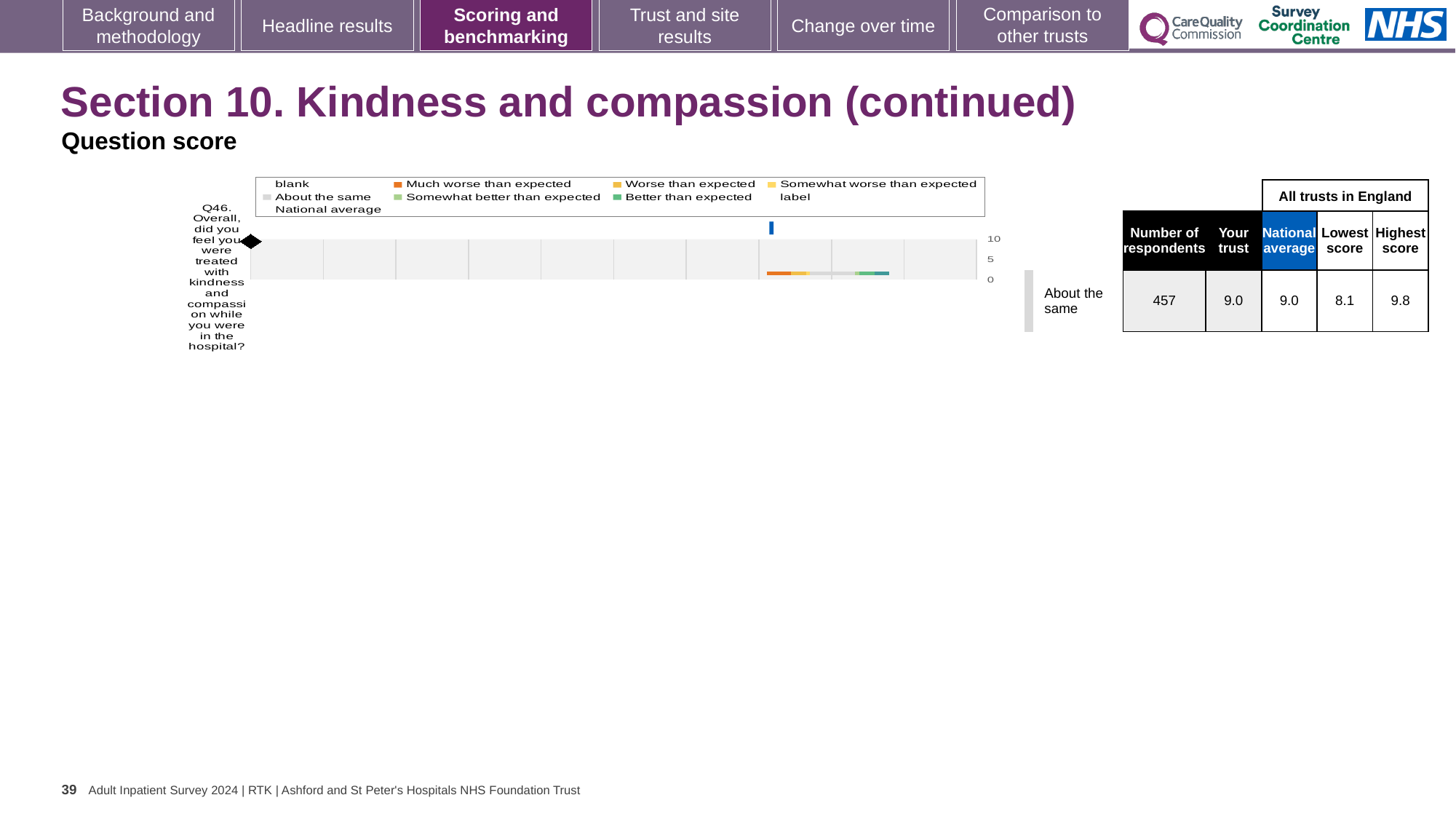
According to the table beside the chart, what is the national average score for Q46? 9.0 What is the difference between the highest score and the lowest score among all trusts in England for Q46? 1.7 According to the table beside the chart, what is the score for your trust on Q46? 9.0 What is the highest value shown on the chart's axis? 10 What kind of chart is shown on the slide? bar chart How many entries does the chart legend list? 9 According to the table beside the chart, what is the highest score among all trusts in England for Q46? 9.8 How many questions (categories) are plotted on the chart? 1 Which question is plotted on the chart? Q46. Overall, did you feel you were treated with kindness and compassion while you were in the hospital? According to the table beside the chart, how many respondents answered Q46? 457 Is the national average marker on the chart greater or less than 5? greater According to the table beside the chart, what is the lowest score among all trusts in England for Q46? 8.1